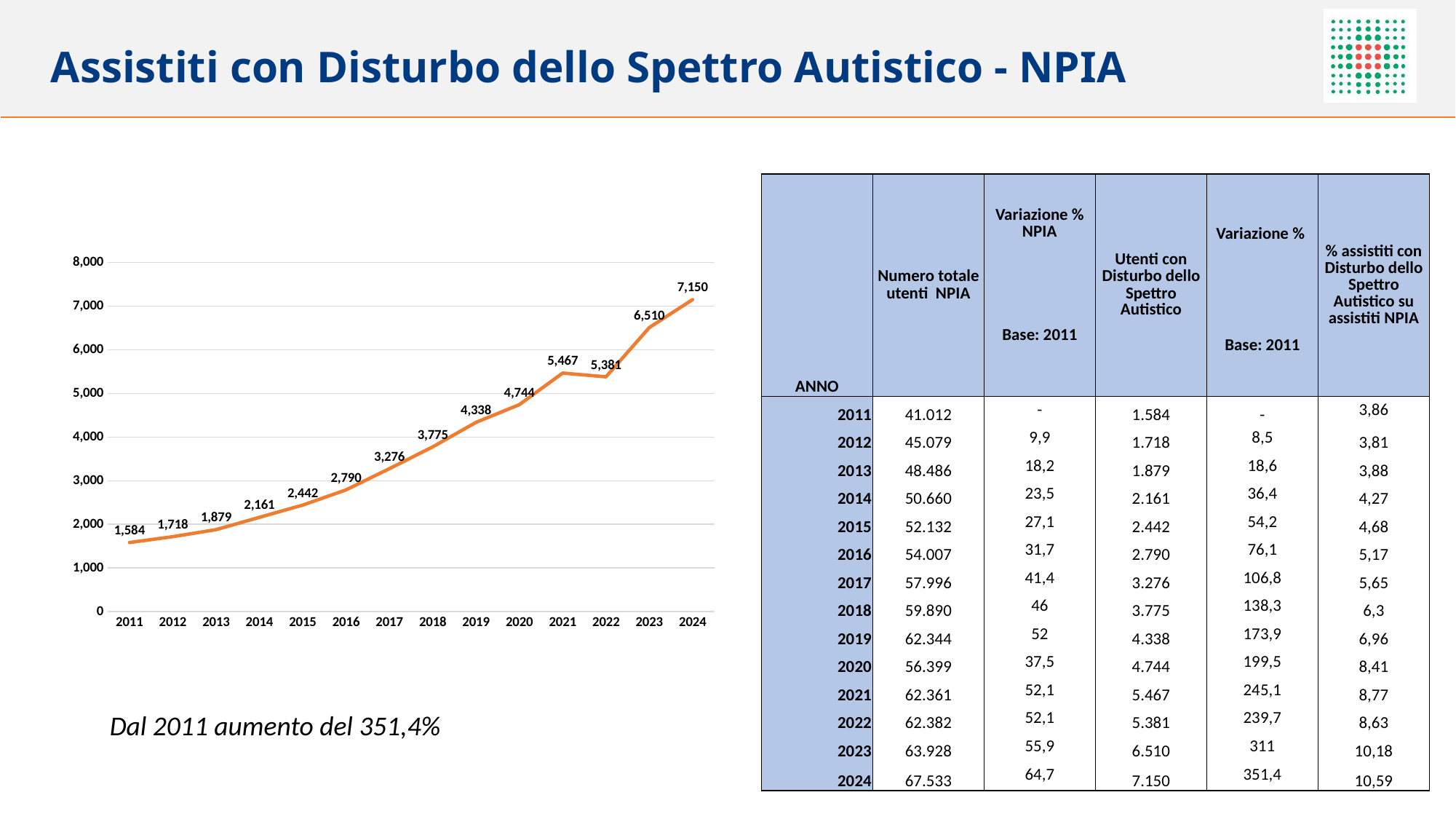
How many years are plotted on the x axis of the line chart? 14 What is the difference between the values for 2024 and 2023 in the line chart? 640 Which year has the larger value in the line chart, 2021 or 2022? 2021 Does the line in the chart generally rise or fall from 2011 to 2024? rise Is the value for 2020 in the line chart greater or less than 5,000? less What is the value plotted for 2018 in the line chart? 3,775 What is the value plotted for 2024 in the line chart? 7,150 What is the value plotted for 2011 in the line chart? 1,584 What is the difference between the values for 2012 and 2011 in the line chart? 134 Which year has the lowest value in the line chart? 2011 What type of chart is shown on the slide? line chart Which year has the highest value in the line chart? 2024